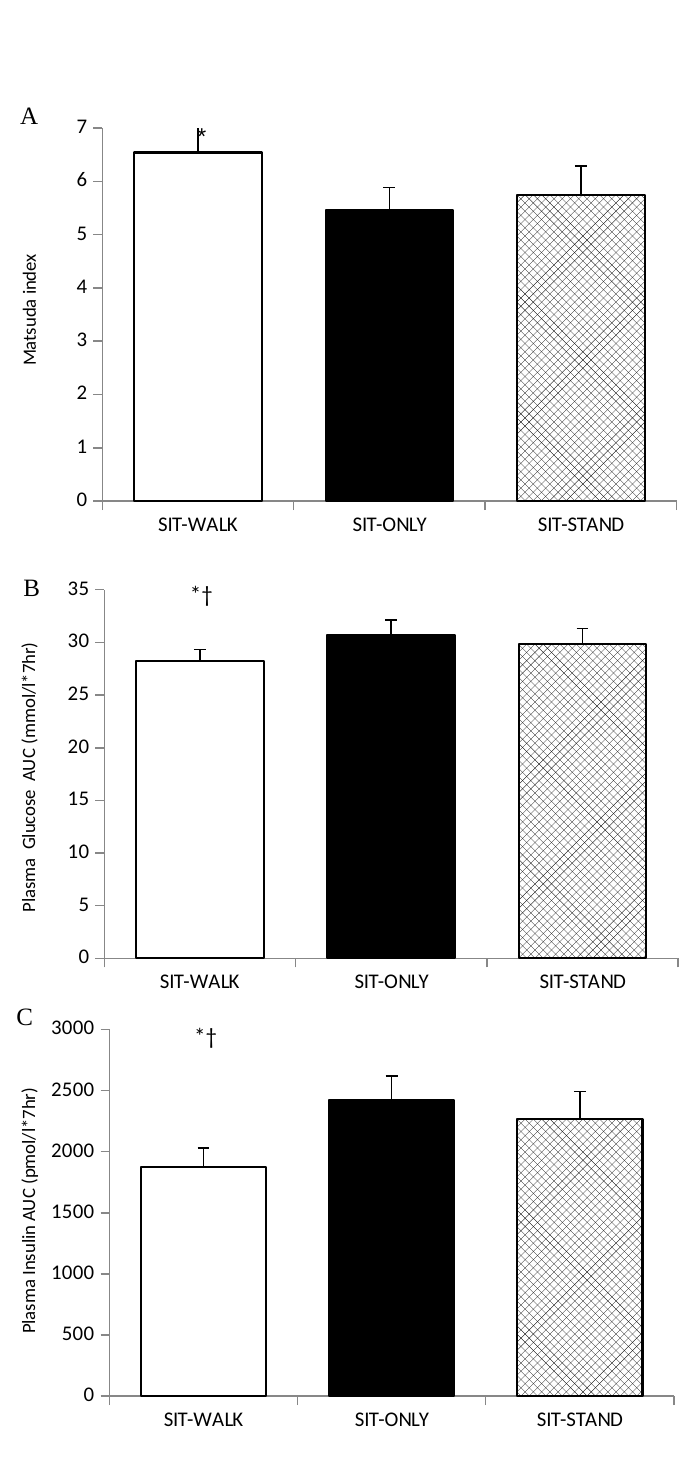
In chart B (Plasma Glucose AUC), is the value for SIT-ONLY greater or less than 30? greater In chart A (Matsuda index), is the value for SIT-WALK greater or less than 6? greater In chart A (Matsuda index), is the value for SIT-ONLY greater or less than 6? less In chart C (Plasma Insulin AUC), which category has the lowest value? SIT-WALK In chart C (Plasma Insulin AUC), which is larger, the value for SIT-ONLY or the value for SIT-WALK? SIT-ONLY How many categories are shown on the x axis of chart C (Plasma Insulin AUC)? 3 In chart A (Matsuda index), which category has the highest value? SIT-WALK What kind of chart is chart B (Plasma Glucose AUC)? bar chart In chart B (Plasma Glucose AUC), which category has the lowest value? SIT-WALK In chart A (Matsuda index), which is larger, the value for SIT-WALK or the value for SIT-ONLY? SIT-WALK